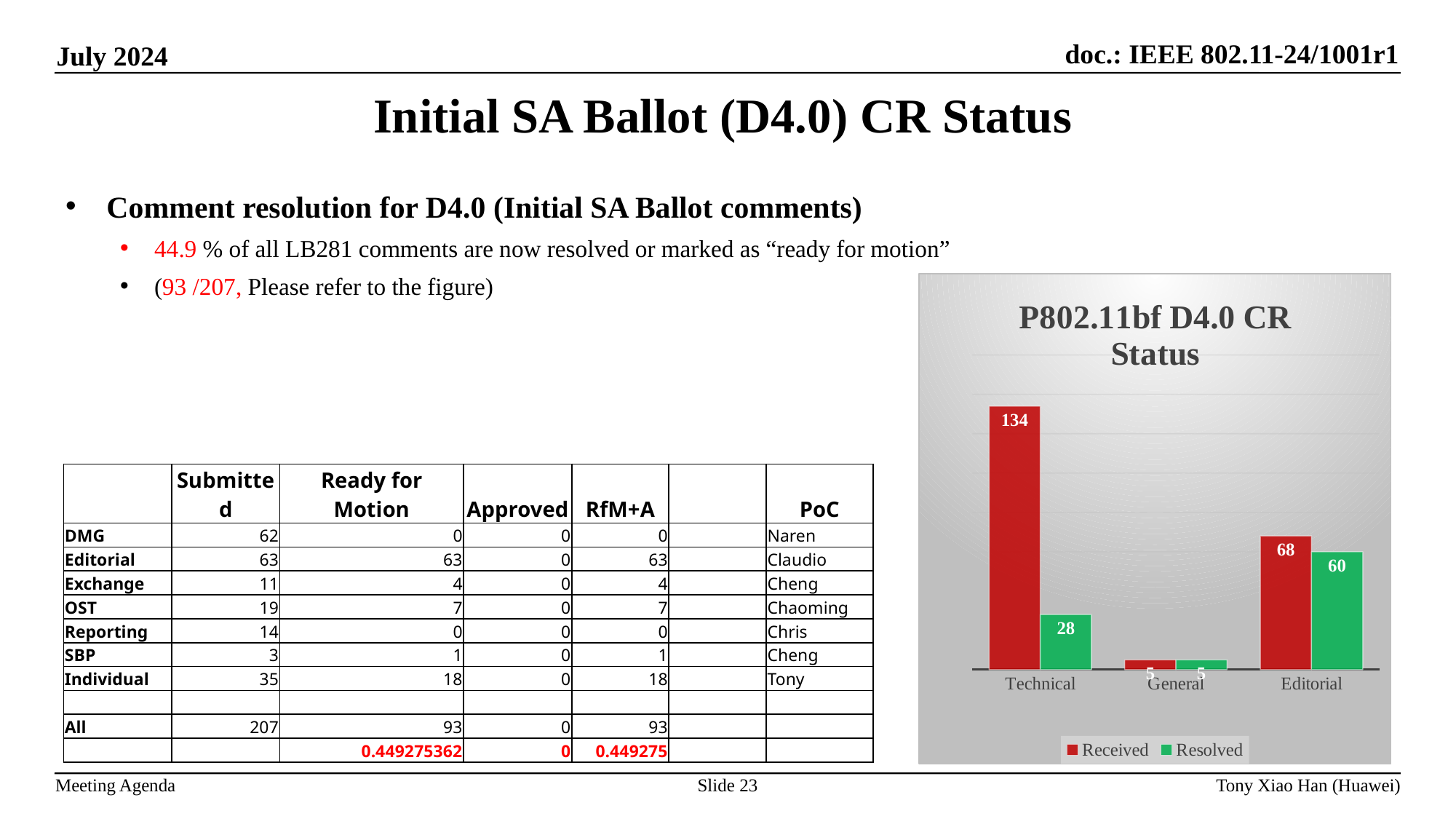
Which is larger, the Received value for Editorial or the Resolved value for Editorial? Received What kind of chart is shown on the slide? bar chart What is the Resolved value for Technical? 28 What is the difference between Received and Resolved for Technical? 106 Which series is shown in green in the chart? Resolved What is the Resolved value for Editorial? 60 Which category has the highest Received value? Technical What is the Received value for Technical? 134 What is the title of the chart? P802.11bf D4.0 CR Status Which category has the lowest Resolved value? General How many series does the chart legend list? 2 How many categories are shown on the x axis of the chart? 3